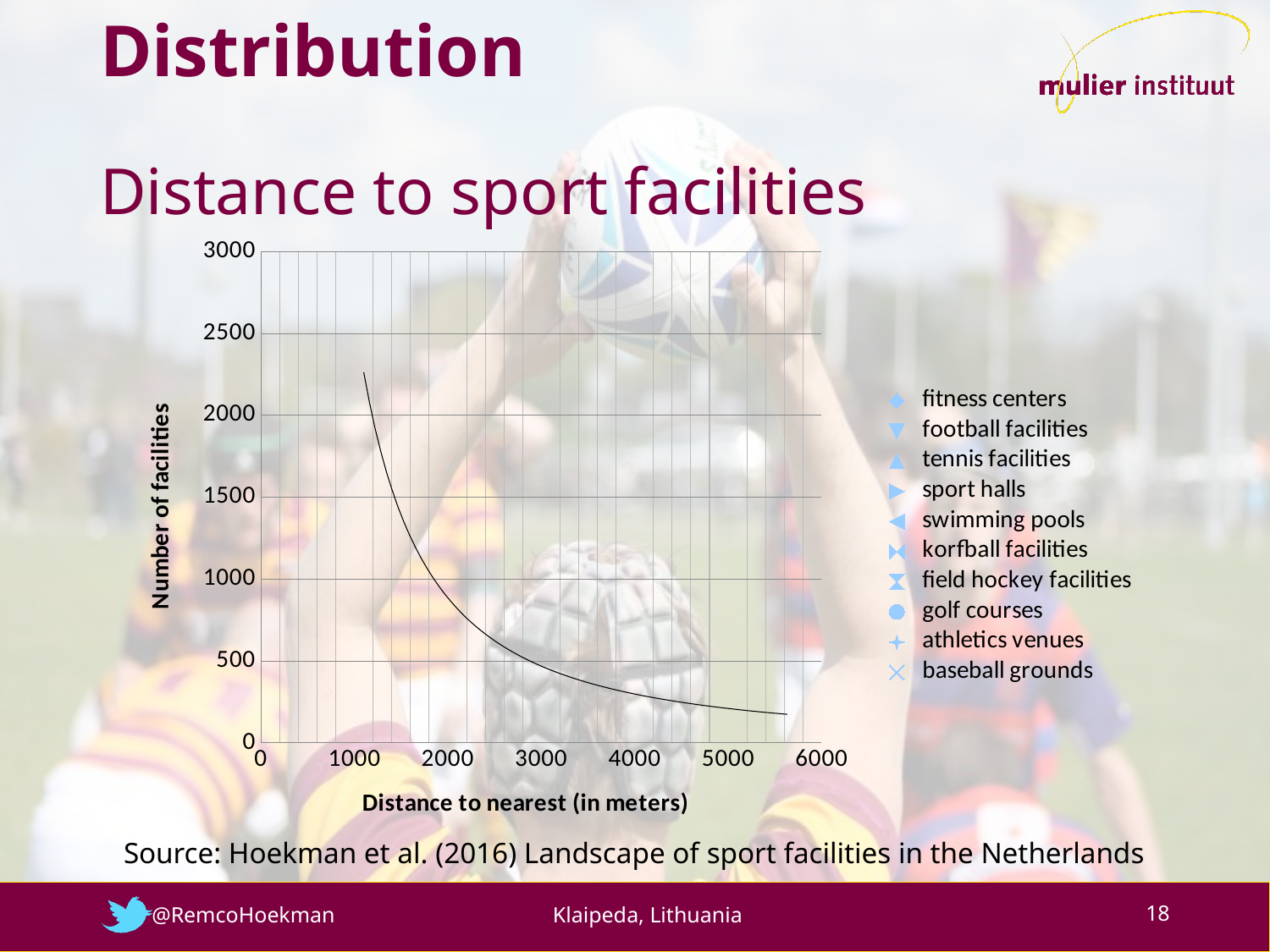
What is the label of the y axis? Number of facilities What is the title of the chart? Distance to sport facilities Is the value of the curve at a distance of 1500 meters greater or less than 1000? greater Does the curve rise or fall as the distance to the nearest facility increases? fall How many series does the chart's legend list? 10 Which series is listed last in the legend? baseball grounds Is the value of the curve at a distance of 4000 meters greater or less than 500? less Which series is listed first in the legend? fitness centers What is the label of the x axis? Distance to nearest (in meters) Is the value of the curve at a distance of 5000 meters greater or less than 1000? less What is the highest value shown on the x axis? 6000 What is the highest value shown on the y axis? 3000